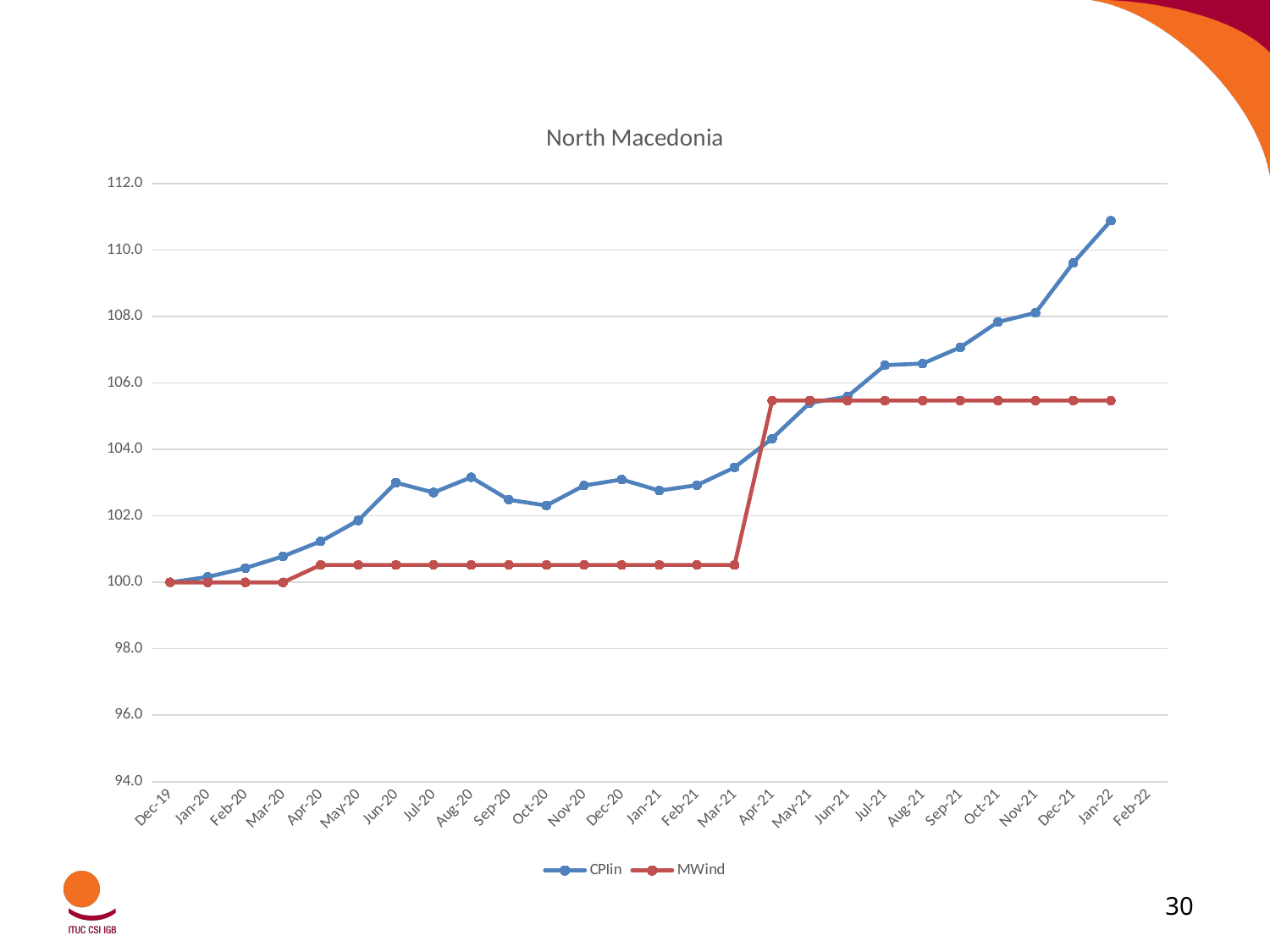
What kind of chart is shown on the slide? line chart What is the value of CPIin at Dec-19? 100.0 What is the value of MWind at Mar-20? 100.0 How many series does the legend list? 2 At Jan-22, which series has the larger value, CPIin or MWind? CPIin At which month is CPIin at its lowest value? Dec-19 What is the title of the chart? North Macedonia Is the value of CPIin at Jun-20 greater or less than 102.0? greater Is the value of CPIin at Jan-22 greater or less than 110.0? greater At which month does CPIin reach its highest value? Jan-22 Is the value of MWind at Jan-22 greater or less than 106.0? less Does the CPIin series generally rise or fall from Dec-19 to Jan-22? rise